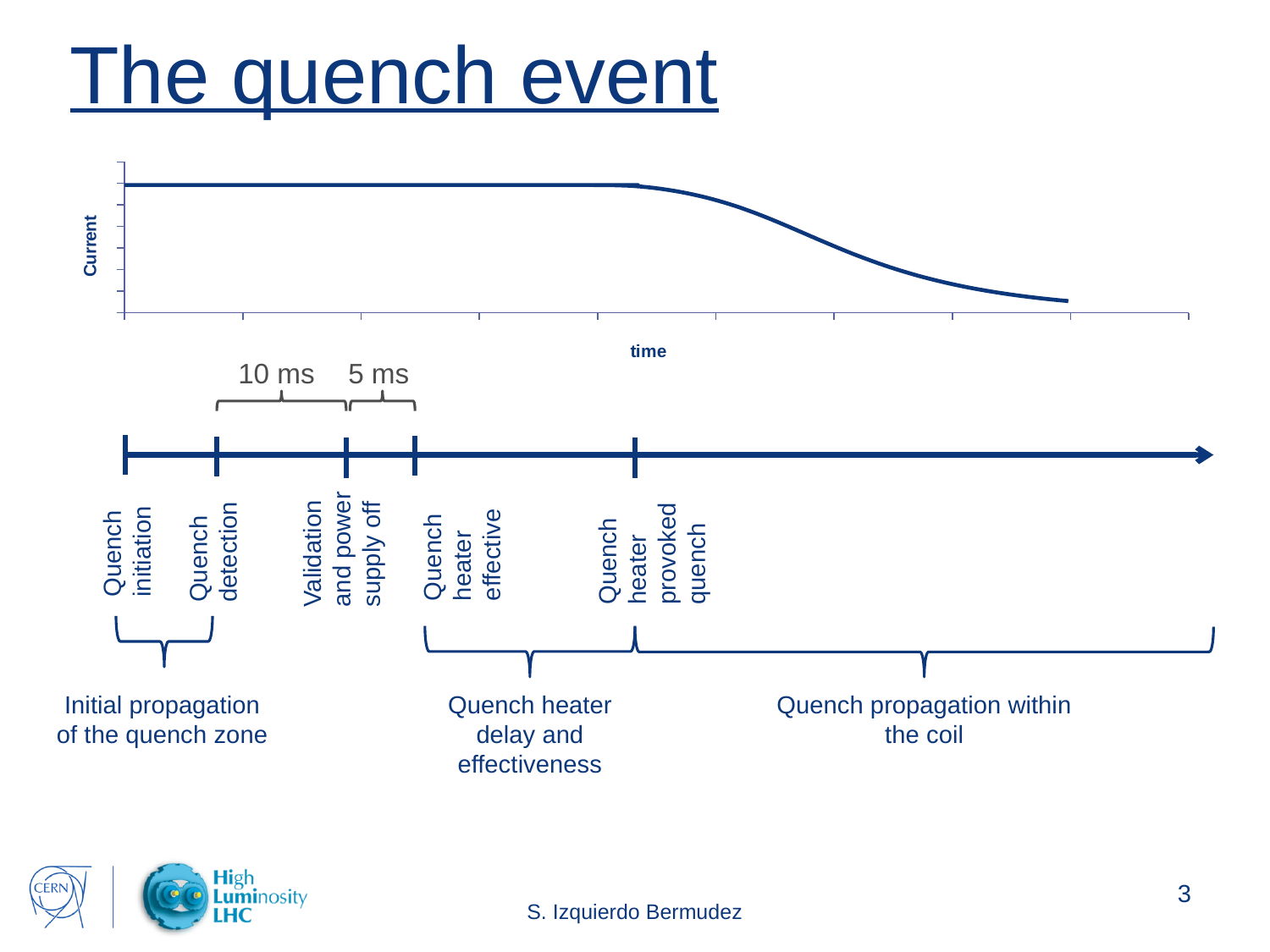
How many labelled events are marked on the timeline below the chart? 5 What kind of chart is shown at the top of the slide? line chart According to the timeline, how long is the interval between quench detection and validation and power supply off? 10 ms Which interval on the timeline is longer: the 10 ms interval after quench detection or the 5 ms interval before the quench heater is effective? the 10 ms interval after quench detection Does the current rise or fall along the time axis after the initial flat section? fall What is the first event labelled on the timeline? Quench initiation What is the label on the horizontal axis of the chart? time What is the label on the vertical axis of the chart? Current What is the difference between the two labelled intervals on the timeline (10 ms and 5 ms)? 5 ms What is the total time from quench detection to the quench heater becoming effective, based on the labelled intervals? 15 ms What is the last event labelled on the timeline? Quench heater provoked quench According to the timeline, how long is the interval between validation and power supply off and the quench heater becoming effective? 5 ms